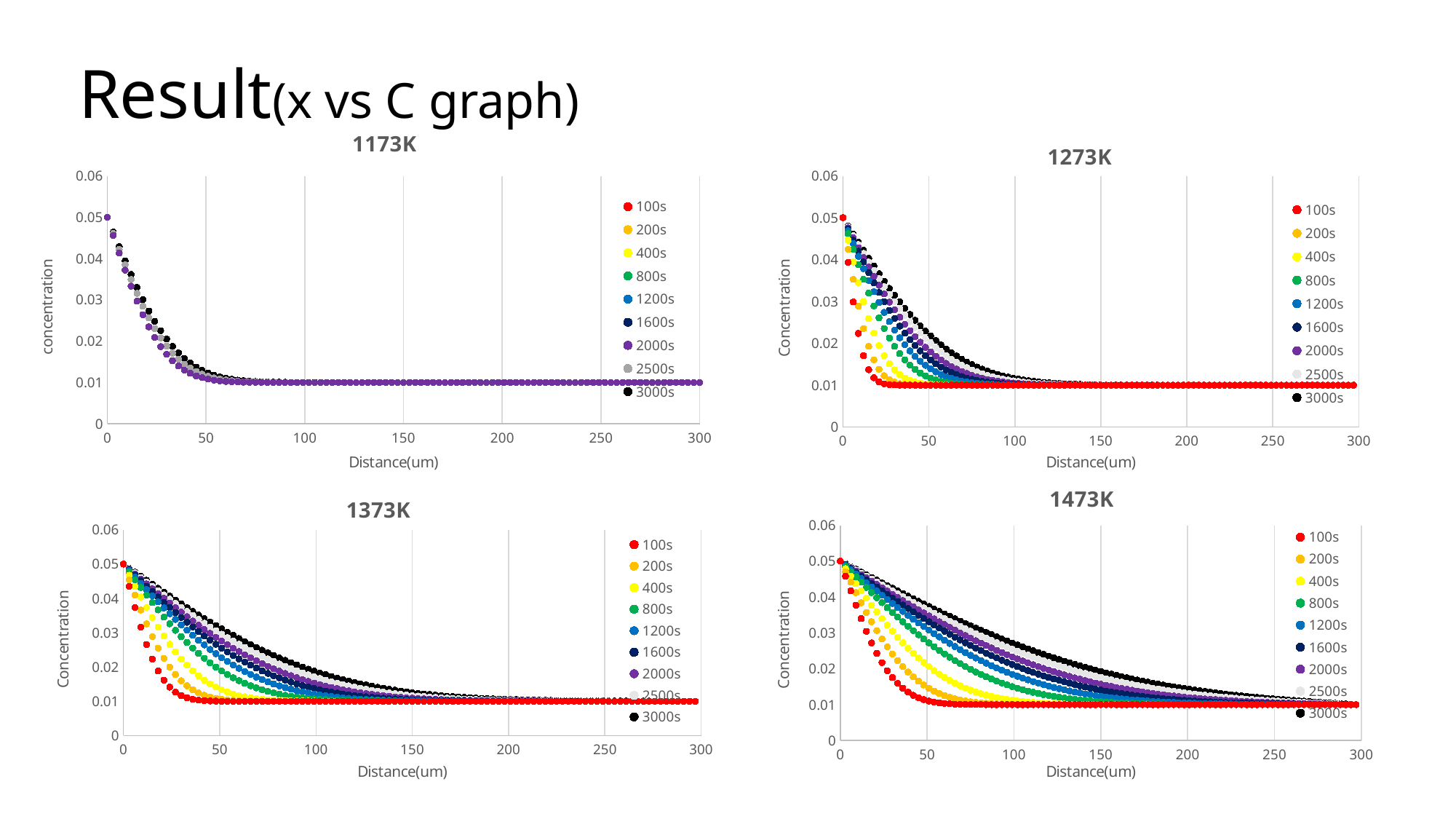
What is the x-axis label of the 1373K chart? Distance(um) How many charts are shown on the slide? 4 In the 1473K chart, is the value for the 3000s series at a distance of 100 um greater or less than 0.02? greater In the 1173K chart, what concentration do the series start at when the distance is 0? 0.05 In the 1273K chart, is the value for the 100s series at a distance of 50 um greater or less than 0.02? less What kind of chart is the 1473K chart? scatter chart In the 1373K chart, do the concentration values rise or fall as distance increases? fall How many series does the legend of the 1273K chart list? 9 What is the title of the chart in the top-left of the slide? 1173K In the 1373K chart, is the value for the 3000s series at a distance of 50 um greater or less than 0.02? greater In the 1473K chart, at a distance of 100 um, which series has the larger concentration: 100s or 3000s? 3000s